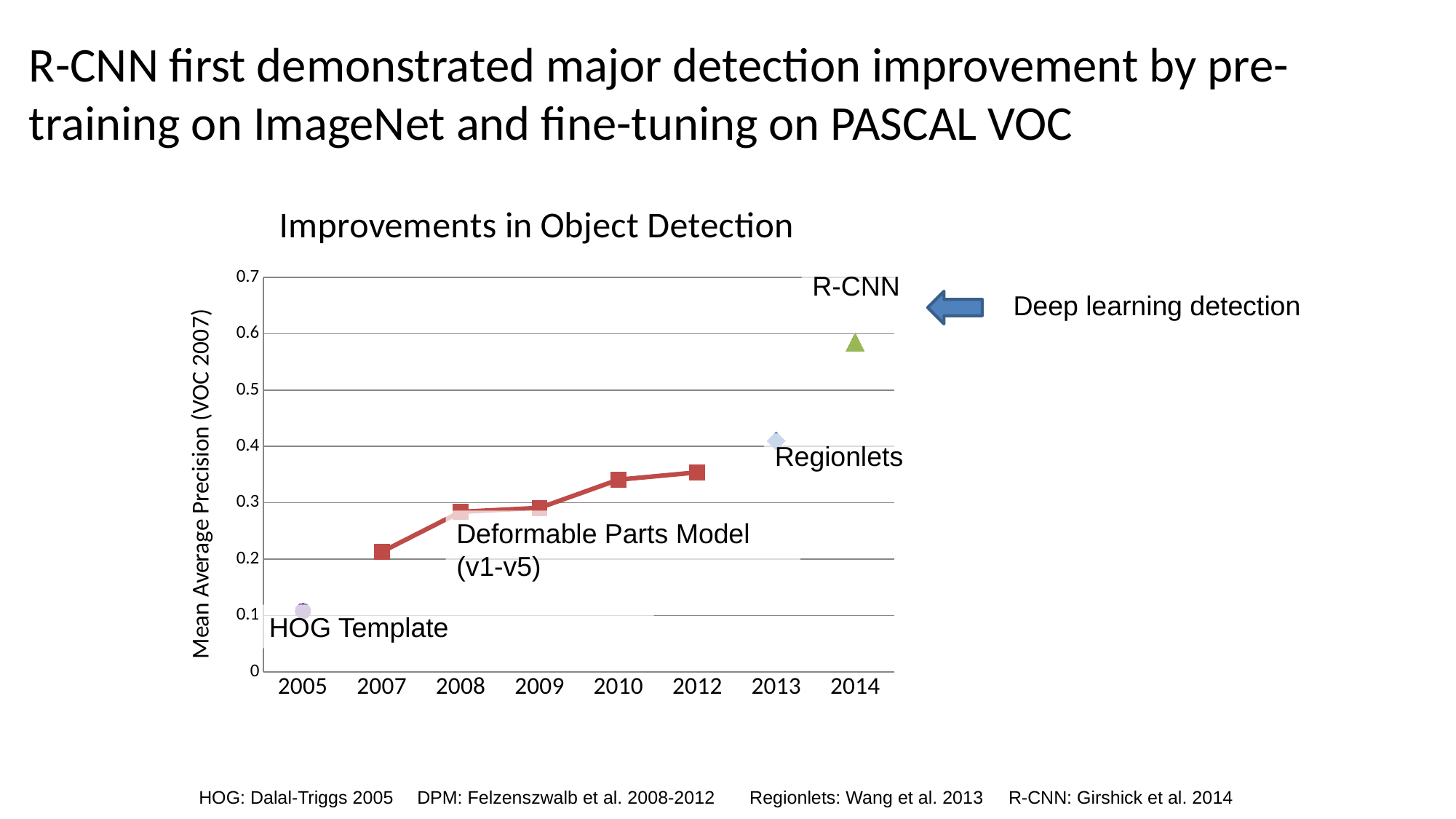
Which labelled method has the highest mean average precision? R-CNN Is the value for 2012 greater or less than 0.3? greater Do the values generally rise or fall from 2005 to 2014? rise What is the title of the chart on the slide? Improvements in Object Detection Which labelled method has the lowest mean average precision? HOG Template Which year on the x axis has the highest mean average precision? 2014 Is the value for R-CNN (2014) greater or less than 0.5? greater Which has the larger mean average precision, 2007 or 2010? 2010 How many years are shown on the x axis of the chart? 8 Is the value for HOG Template (2005) greater or less than 0.2? less What is the label of the y axis of the chart? Mean Average Precision (VOC 2007)